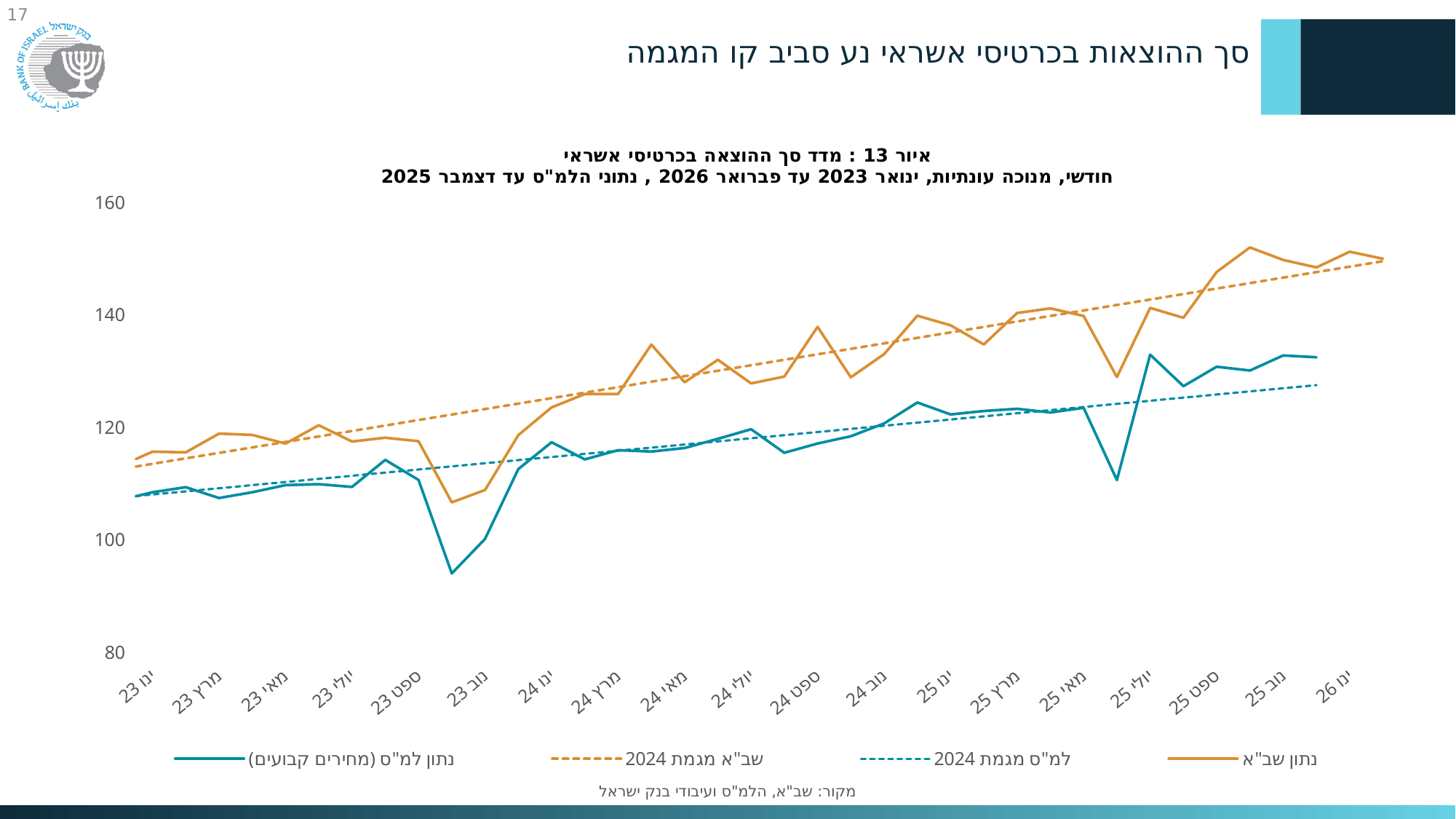
Is the value of נתון שב"א at נוב 23 greater or less than 120? less Overall, do the values of נתון שב"א rise or fall from ינו 23 to ינו 26? rise Which series reaches the highest value on the chart? נתון שב"א What kind of chart is shown on the slide? line chart Is the value of נתון שב"א at ינו 26 greater or less than 140? greater Which series reaches the lowest value on the chart? נתון למ"ס (מחירים קבועים) Which legend entry is drawn as a solid orange line? נתון שב"א What is the figure number given in the chart title? איור 13 How many series does the legend list? 4